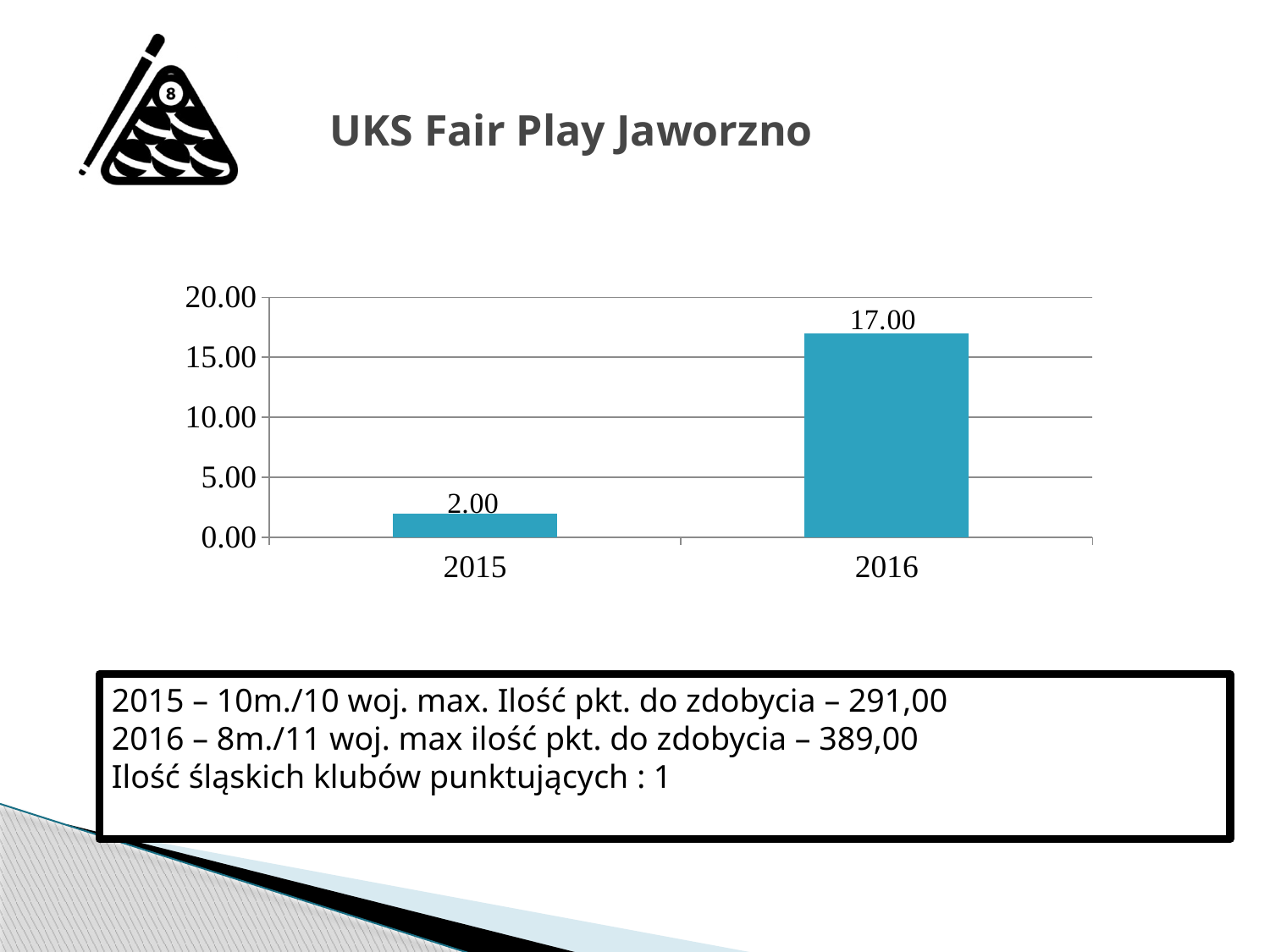
How many years are shown on the x axis? 2 Which year has the lowest value? 2015 What is the value for 2016? 17.00 What is the value for 2015? 2.00 Which year has the highest value? 2016 Do the values rise or fall from 2015 to 2016? rise What is the difference between the values for 2016 and 2015? 15.00 Is the value for 2016 greater or less than 15.00? greater Is the value for 2015 greater or less than 5.00? less What kind of chart is shown on the slide? bar chart Which is larger, the value for 2015 or the value for 2016? 2016 What is the title of the slide containing the chart? UKS Fair Play Jaworzno